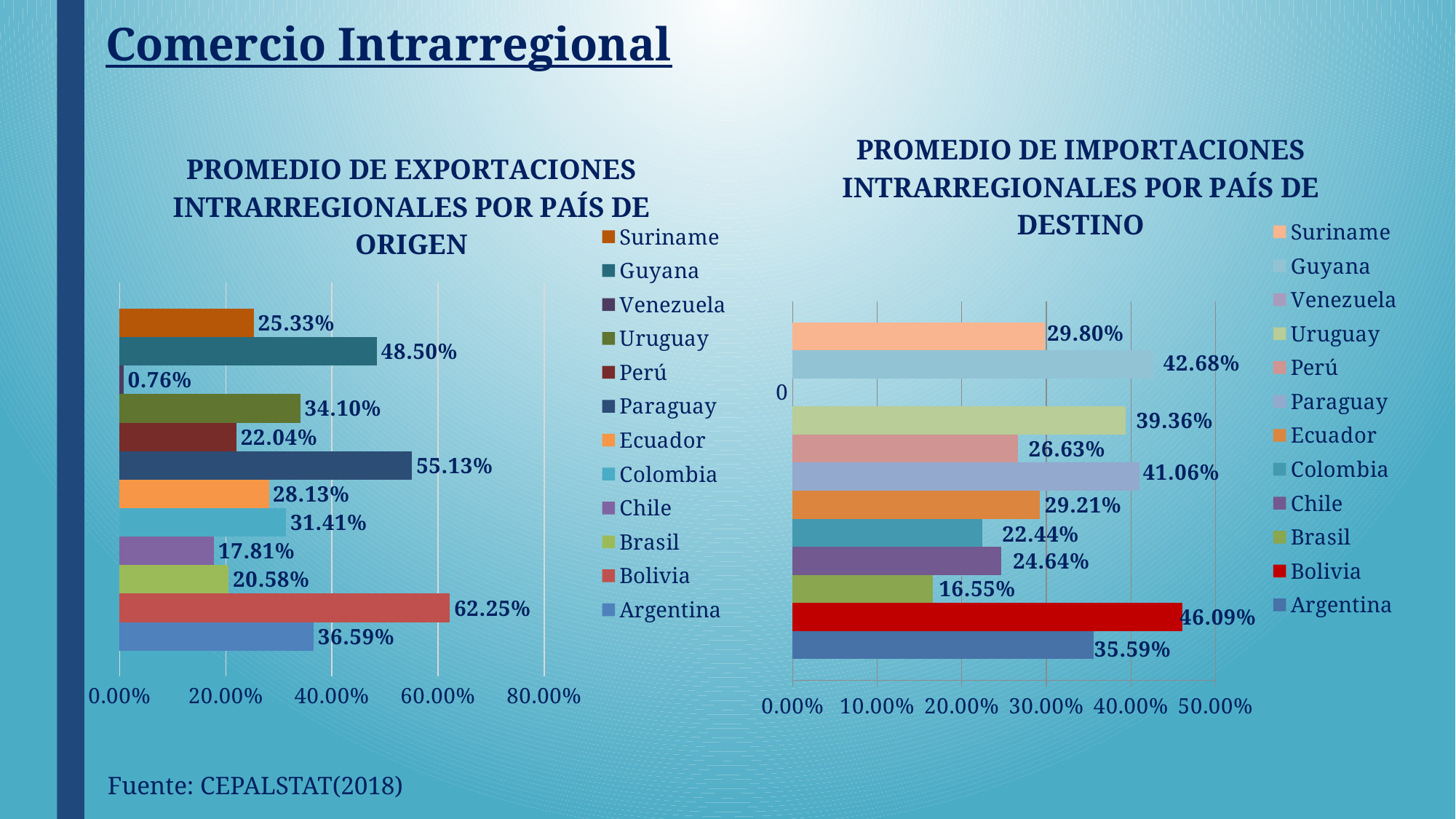
In the chart 'Promedio de importaciones intrarregionales por país de destino', what is the value for Bolivia? 46.09% How many series does the legend of the chart 'Promedio de importaciones intrarregionales por país de destino' list? 12 In the chart 'Promedio de exportaciones intrarregionales por país de origen', which country has the highest value? Bolivia In the chart 'Promedio de exportaciones intrarregionales por país de origen', what is the value for Paraguay? 55.13% What kind of chart is 'Promedio de exportaciones intrarregionales por país de origen'? Bar chart In the chart 'Promedio de exportaciones intrarregionales por país de origen', what is the difference between the values for Guyana and Suriname? 23.17% In the chart 'Promedio de importaciones intrarregionales por país de destino', what is the value for Brasil? 16.55% In the chart 'Promedio de exportaciones intrarregionales por país de origen', which country has the lowest value? Venezuela In the chart 'Promedio de exportaciones intrarregionales por país de origen', what is the value for Bolivia? 62.25% In the chart 'Promedio de exportaciones intrarregionales por país de origen', is the value for Argentina greater or less than 40.00%? less In the chart 'Promedio de importaciones intrarregionales por país de destino', which country has the highest value? Bolivia In the chart 'Promedio de importaciones intrarregionales por país de destino', which is larger, the value for Guyana or the value for Paraguay? Guyana